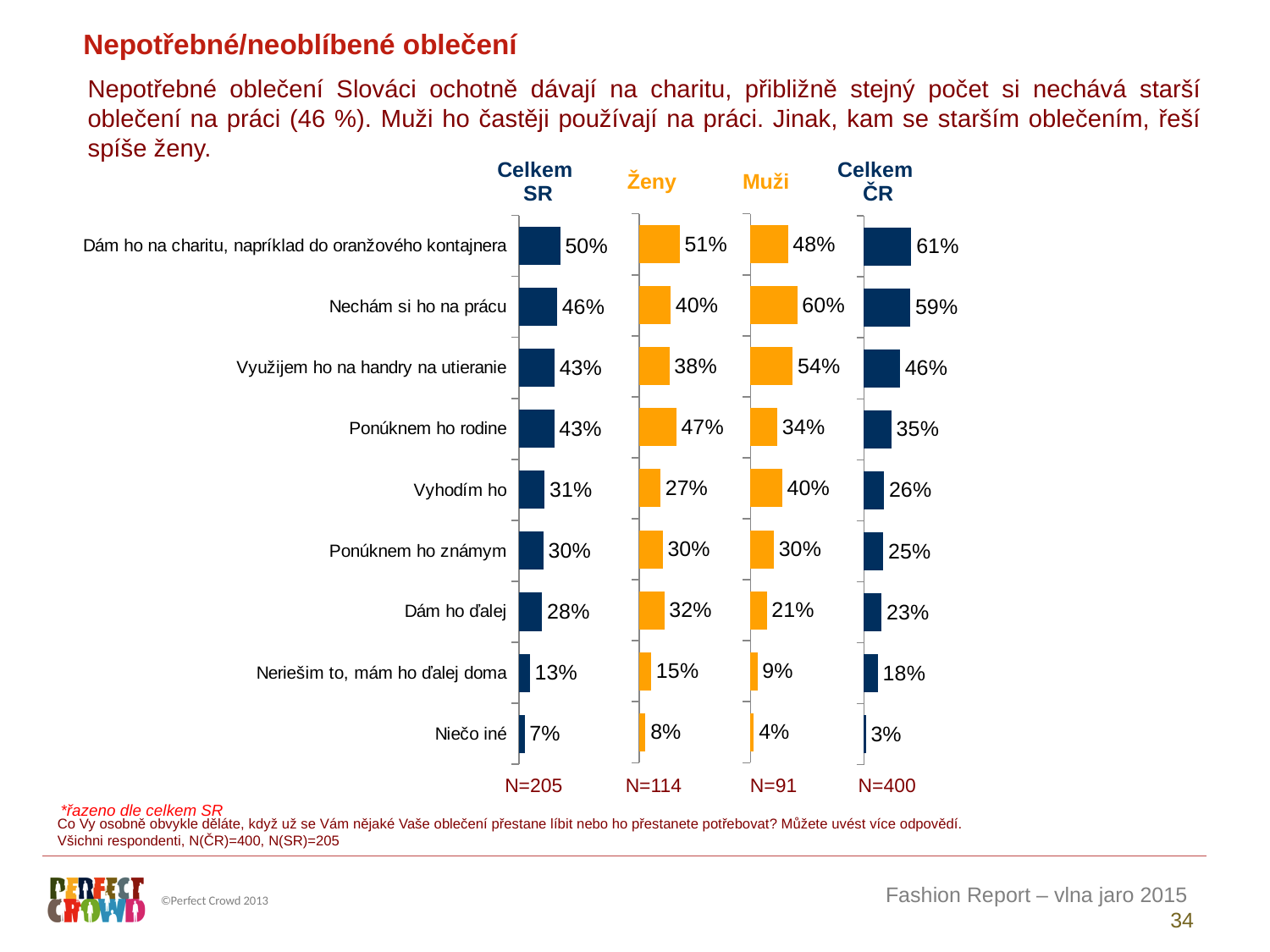
How many categories are shown in the Celkem SR chart? 9 In the Celkem ČR chart, what is the value for "Dám ho na charitu, napríklad do oranžového kontajnera"? 61% In the Muži chart, what is the value for "Nechám si ho na prácu"? 60% In the Ženy chart, which category has the highest value? Dám ho na charitu, napríklad do oranžového kontajnera For "Vyhodím ho", which chart shows the larger value, Ženy or Muži? Muži In the Muži chart, which category has the lowest value? Niečo iné In the Celkem ČR chart, do the values rise or fall from the top category to the bottom category? Fall In the Ženy chart, what is the value for "Dám ho ďalej"? 32% In the Celkem SR chart, what is the value for "Nechám si ho na prácu"? 46% What is the sample size (N) shown under the Ženy chart? N=114 What type of chart is used on this slide? Bar chart In the Muži chart, what is the difference between "Nechám si ho na prácu" and "Ponúknem ho rodine"? 26%